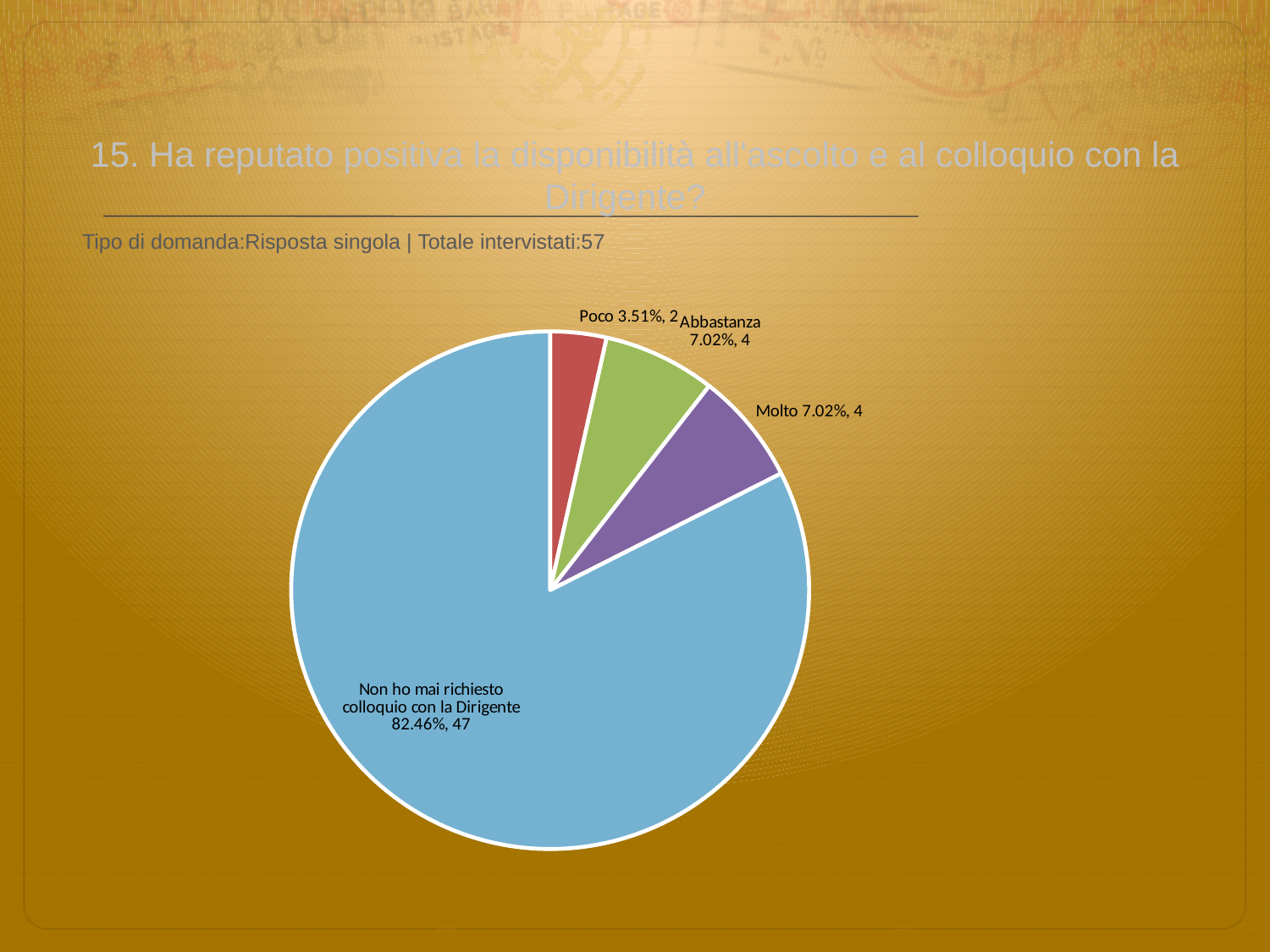
Which category has the smallest slice of the pie? Poco What percentage share does the 'Abbastanza' slice have? 7.02% What colour is the 'Molto' slice? purple How many slices does the pie chart have? 4 What is the difference in number of respondents between 'Non ho mai richiesto colloquio con la Dirigente' and 'Molto'? 43 What kind of chart is shown on the slide? pie chart Which has more respondents, 'Abbastanza' or 'Poco'? Abbastanza How many respondents chose 'Molto'? 4 What is the total number of respondents shown in the pie chart? 57 What percentage share does the 'Non ho mai richiesto colloquio con la Dirigente' slice have? 82.46% Which category has the largest slice of the pie? Non ho mai richiesto colloquio con la Dirigente How many respondents chose 'Poco'? 2